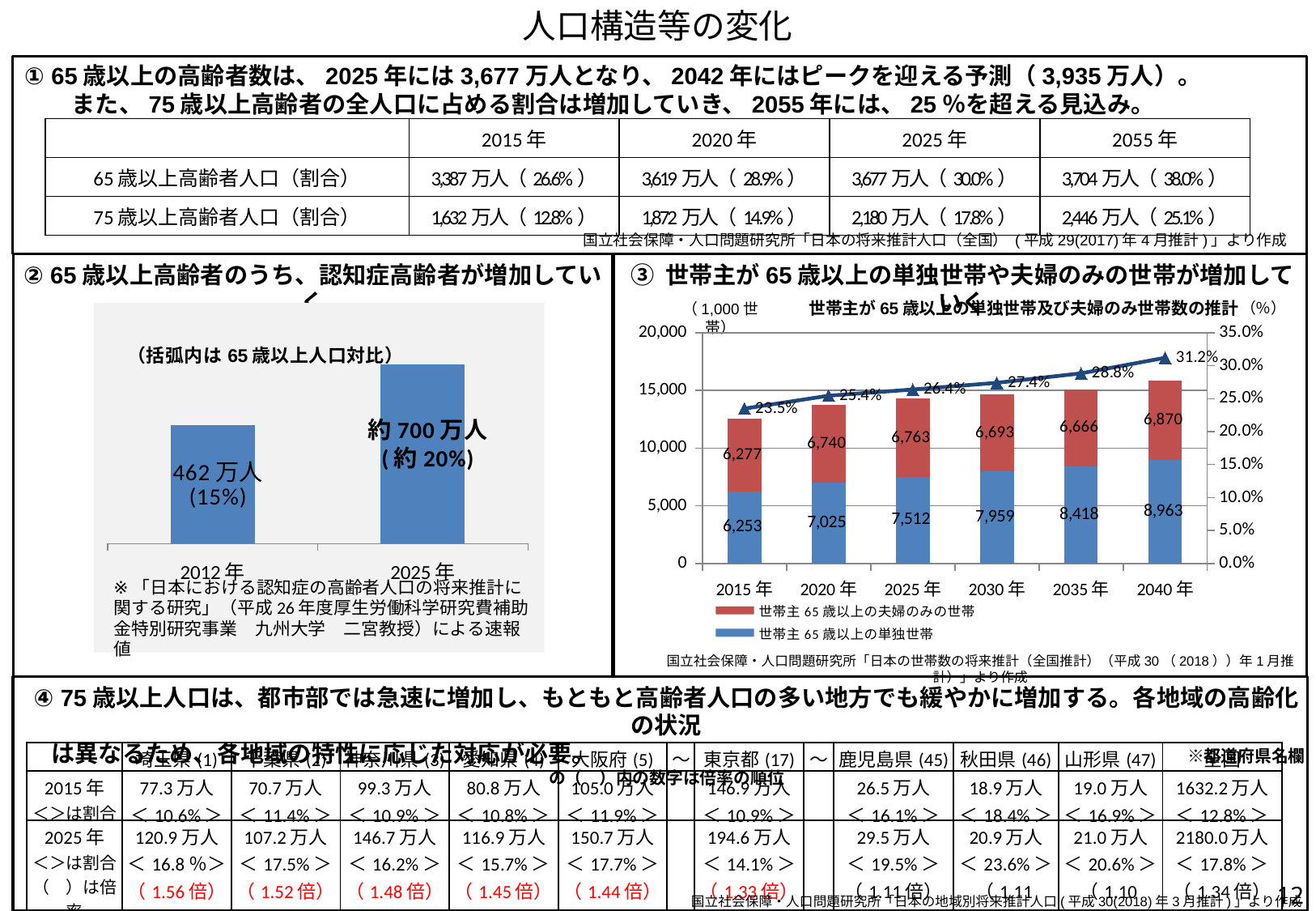
In the right chart (③, households headed by 65+), does the percentage line rise or fall from 2015年 to 2040年? rise In the left chart (②, dementia elderly), what kind of chart is it? bar chart In the right chart (③, households headed by 65+), what is the difference between the 単独世帯 values for 2040年 and 2015年? 2,710 In the right chart (③, households headed by 65+), what is the value for 世帯主65歳以上の夫婦のみの世帯 in 2015年? 6,277 In the right chart (③, households headed by 65+), what is the total of the stacked bar for 2015年? 12,530 In the right chart (③, households headed by 65+), what percentage does the line show for 2035年? 28.8% In the left chart (②, dementia elderly), what is the value for 2012年? 462万人 In the left chart (②, dementia elderly), what share of the 65+ population is shown in parentheses for 2025年? 約20% In the right chart (③, households headed by 65+), what is the value for 世帯主65歳以上の単独世帯 in 2040年? 8,963 In the right chart (③, households headed by 65+), how many series does the legend list? 2 In the right chart (③, households headed by 65+), which year has the highest value for 世帯主65歳以上の夫婦のみの世帯? 2040年 In the left chart (②, dementia elderly), how many bars are plotted? 2